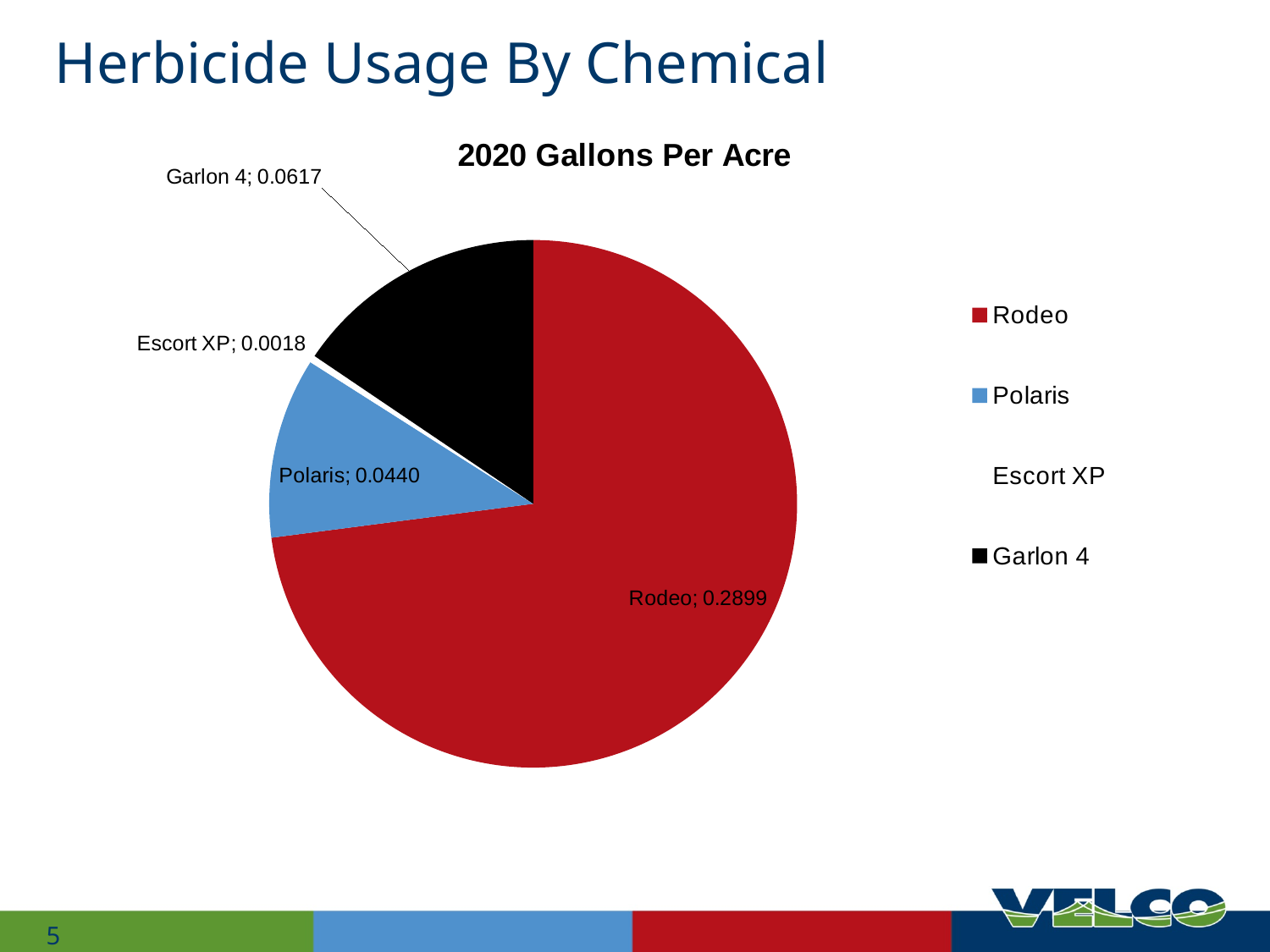
What is the value for Escort XP in the 2020 Gallons Per Acre chart? 0.0018 What is the value for Rodeo in the 2020 Gallons Per Acre chart? 0.2899 How many chemicals are shown in the pie chart? 4 What is the difference between the values for Garlon 4 and Polaris? 0.0177 Which chemical has the smallest slice of the pie? Escort XP Which is larger, the value for Garlon 4 or the value for Polaris? Garlon 4 What is the difference between the values for Rodeo and Polaris? 0.2459 What is the value for Garlon 4 in the 2020 Gallons Per Acre chart? 0.0617 What is the value for Polaris in the 2020 Gallons Per Acre chart? 0.0440 What type of chart is shown on the slide? Pie chart Which chemical has the largest slice of the pie? Rodeo What is the title of the chart? 2020 Gallons Per Acre